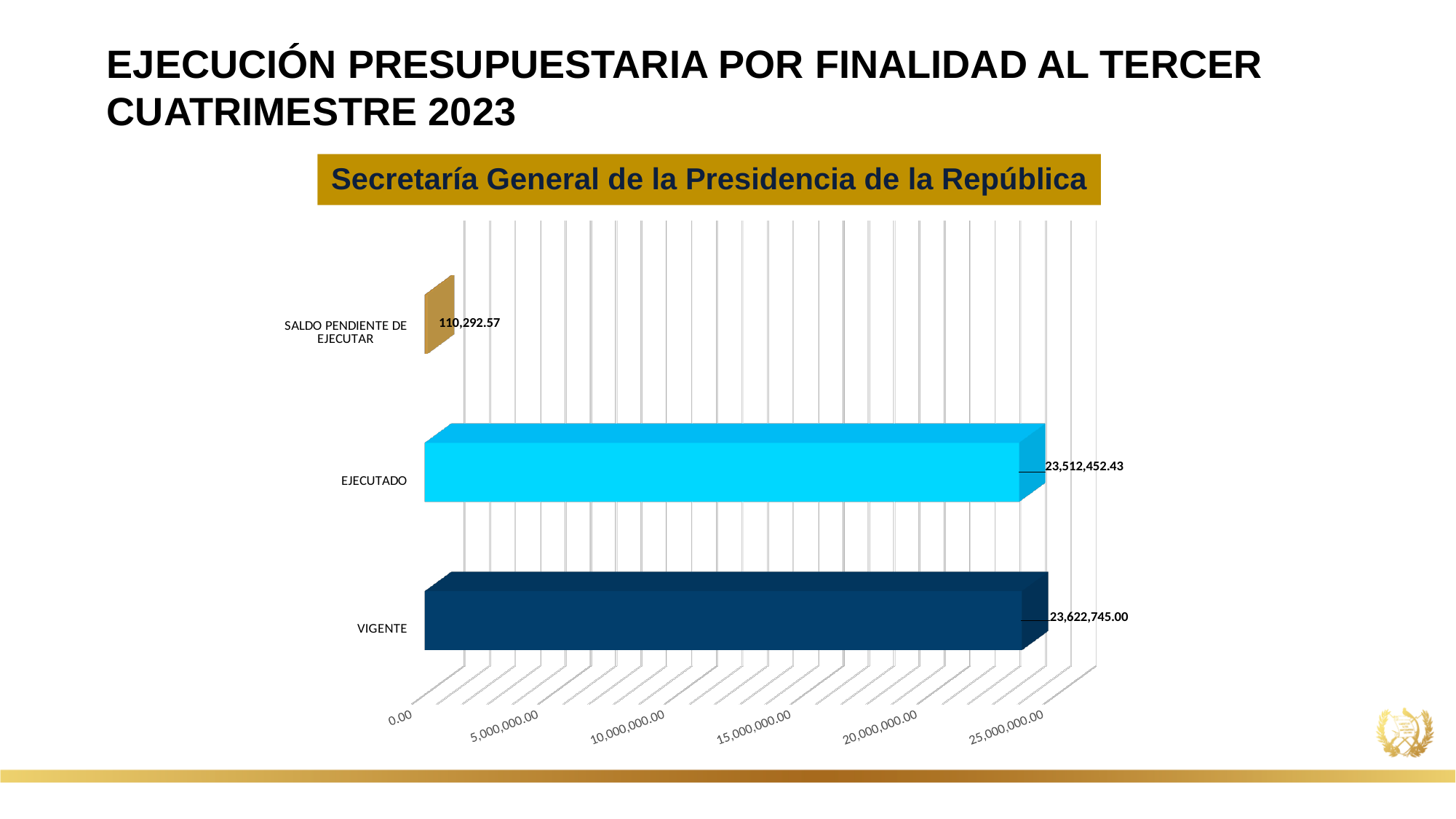
What is the title of the chart? Secretaría General de la Presidencia de la República Is the value for SALDO PENDIENTE DE EJECUTAR greater or less than 5,000,000.00? less Is the value for EJECUTADO greater or less than 20,000,000.00? greater Which category has the lowest value? SALDO PENDIENTE DE EJECUTAR How many categories are shown in the chart? 3 What is the value for EJECUTADO? 23,512,452.43 What is the value for SALDO PENDIENTE DE EJECUTAR? 110,292.57 Which category has the highest value? VIGENTE What is the value for VIGENTE? 23,622,745.00 Which is larger, the value for EJECUTADO or the value for SALDO PENDIENTE DE EJECUTAR? EJECUTADO What is the difference between the VIGENTE and EJECUTADO values? 110,292.57 What kind of chart is shown on the slide? bar chart